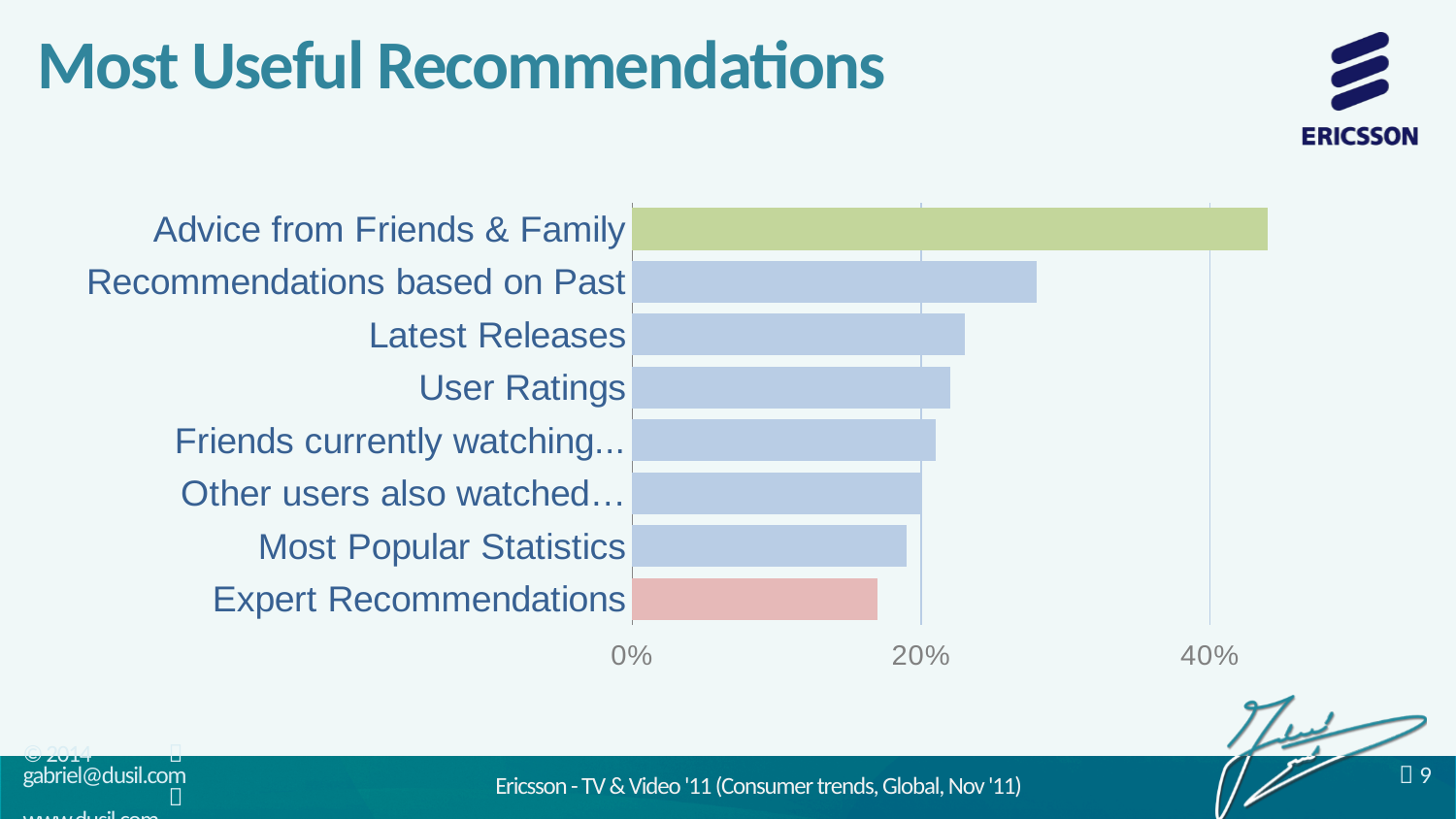
What colour is the bar for Expert Recommendations? pink Is the value for Expert Recommendations greater or less than 20%? less How many categories are plotted in the chart? 8 What kind of chart is shown on the slide? bar chart Which is larger, the value for Advice from Friends & Family or the value for Expert Recommendations? Advice from Friends & Family Which is larger, the value for Recommendations based on Past or the value for Latest Releases? Recommendations based on Past What is the title of the slide containing the chart? Most Useful Recommendations Is the value for Advice from Friends & Family greater or less than 40%? greater Is the value for Latest Releases greater or less than 20%? greater Which category has the lowest value? Expert Recommendations Which category has the highest value? Advice from Friends & Family